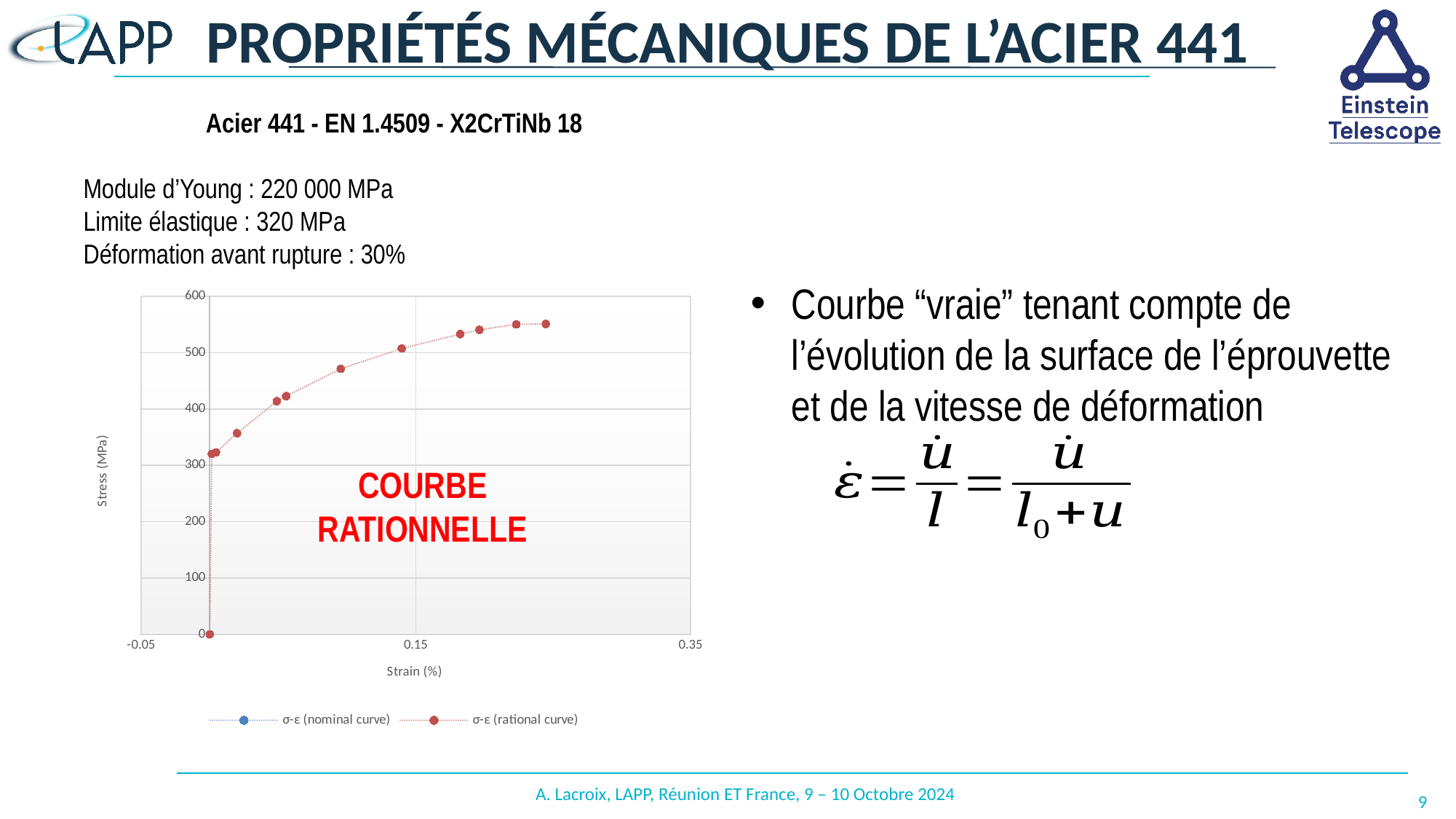
What is the maximum value shown on the stress axis of the chart? 600 What kind of chart is shown on the slide? Scatter (line) chart What is the label of the horizontal axis of the chart? Strain (%) What is the label of the vertical axis of the chart? Stress (MPa) Is the largest strain value plotted on the rational curve greater or less than 0.15? greater Is the largest strain value plotted on the rational curve greater or less than 0.35? less Is the highest stress value plotted on the rational curve greater or less than 600? less How many series does the chart legend list? 2 Does the stress of the rational curve rise or fall as strain increases along the x axis? Rise